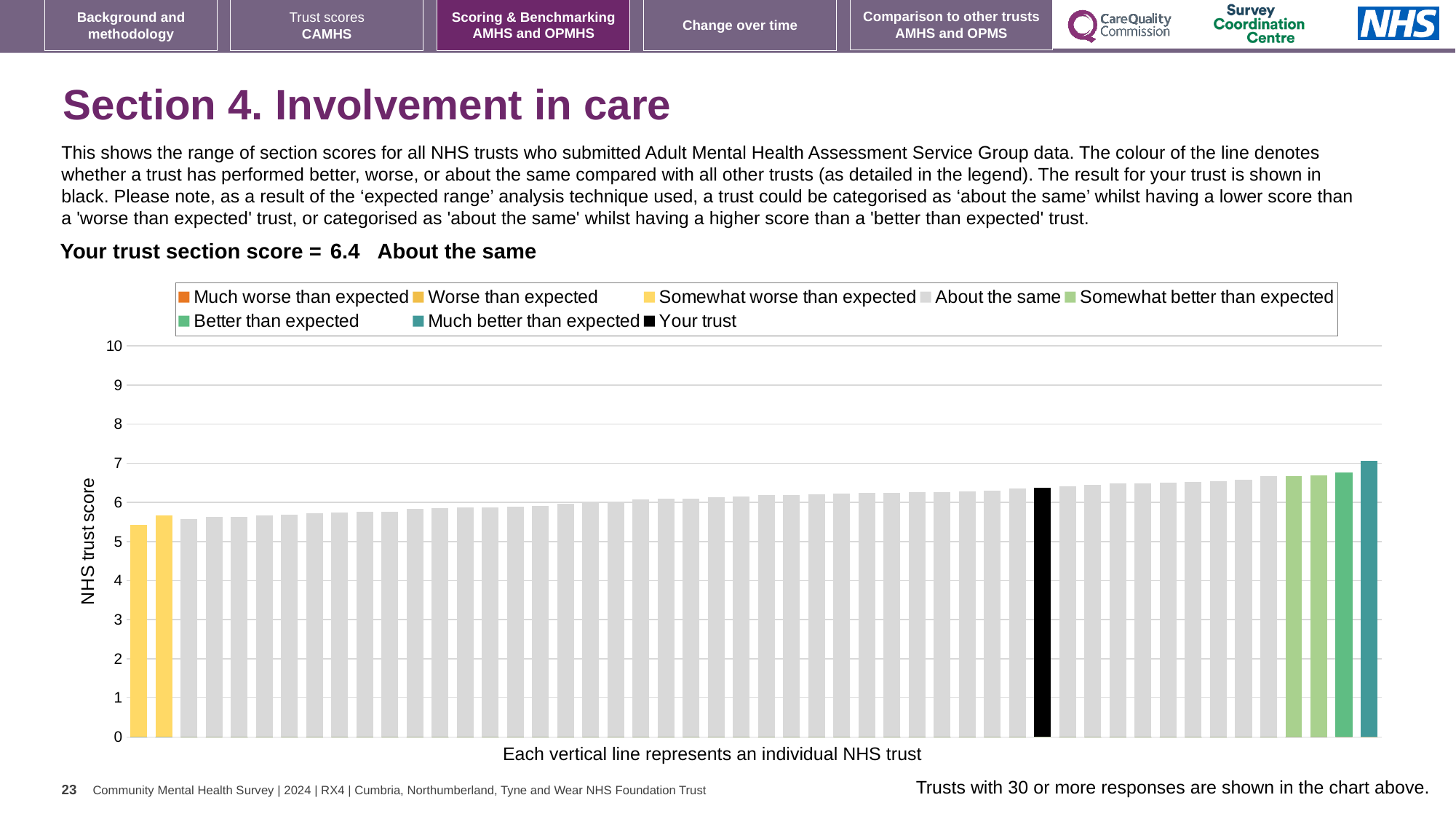
Which legend category does the shortest bar in the chart belong to? Somewhat worse than expected Is the value of the black 'Your trust' bar greater or less than 7? less Is the value of the lowest bar in the chart greater or less than 6? less Do the bar values rise or fall from left to right along the x axis? rise How many entries does the chart legend list? 8 What is the label on the vertical axis of the chart? NHS trust score What colour is the bar representing your trust? Black How many bars are coloured as 'Somewhat worse than expected'? 2 What is the section score for your trust, as printed on the slide? 6.4 What kind of chart is shown on the slide? Bar chart Is the value of the black 'Your trust' bar greater or less than 6? greater Which legend category does the tallest bar in the chart belong to? Much better than expected